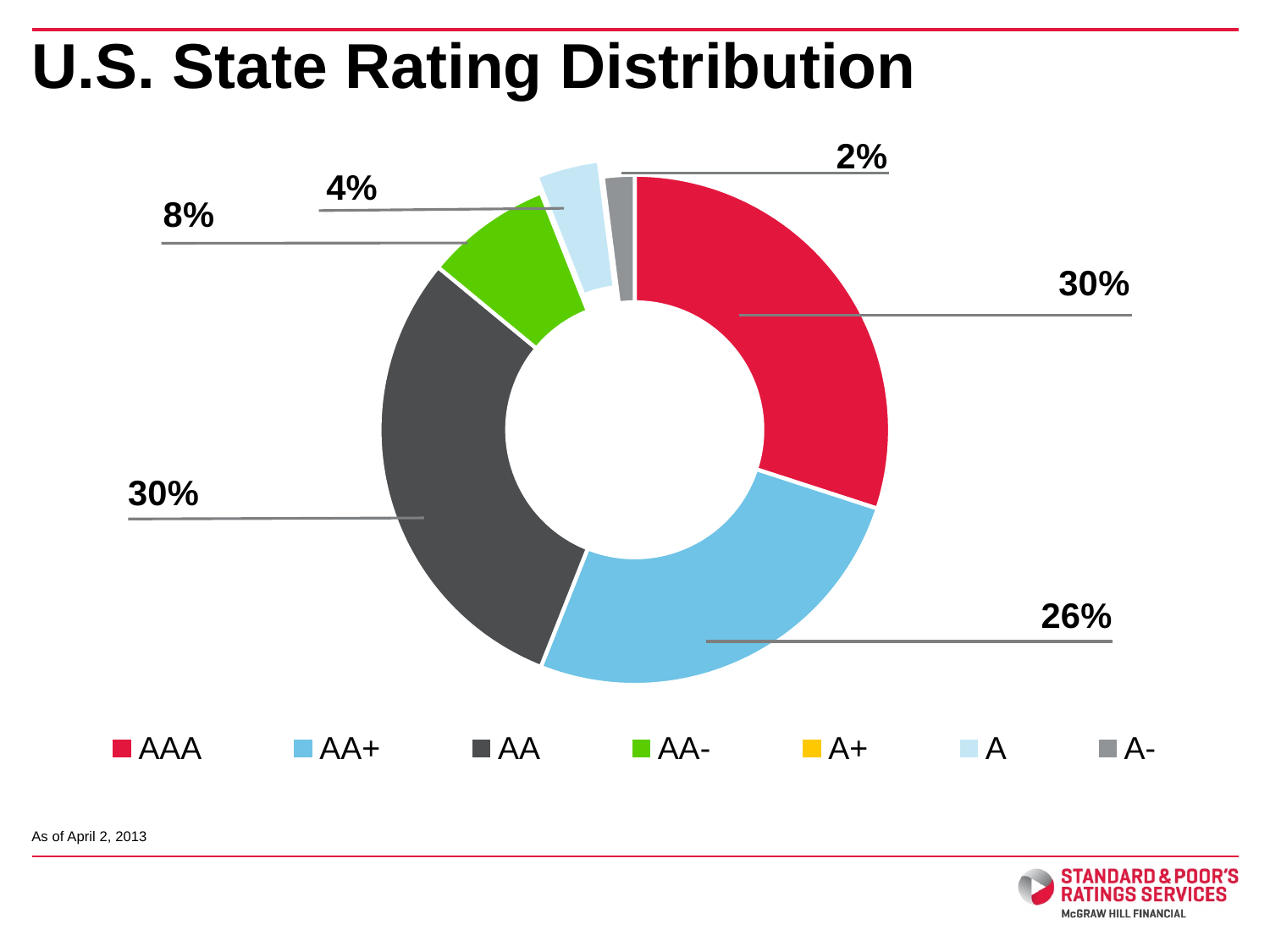
What kind of chart is shown on the slide? Doughnut (pie) chart What is the value shown for the AA- rating? 8% How many rating categories does the legend list? 7 What is the difference between the AA- share and the A share? 4 percentage points What share of the chart does the AA+ rating represent? 26% Which rating has the smallest labelled slice in the chart? A- What percentage is shown for the A- rating? 2% What percentage is shown for the A rating? 4% What is the title of the chart? U.S. State Rating Distribution By how many percentage points does the AAA share exceed the AA+ share? 4 percentage points What percentage of U.S. states are rated AAA? 30% Which is larger, the share for AAA or the share for AA+? AAA